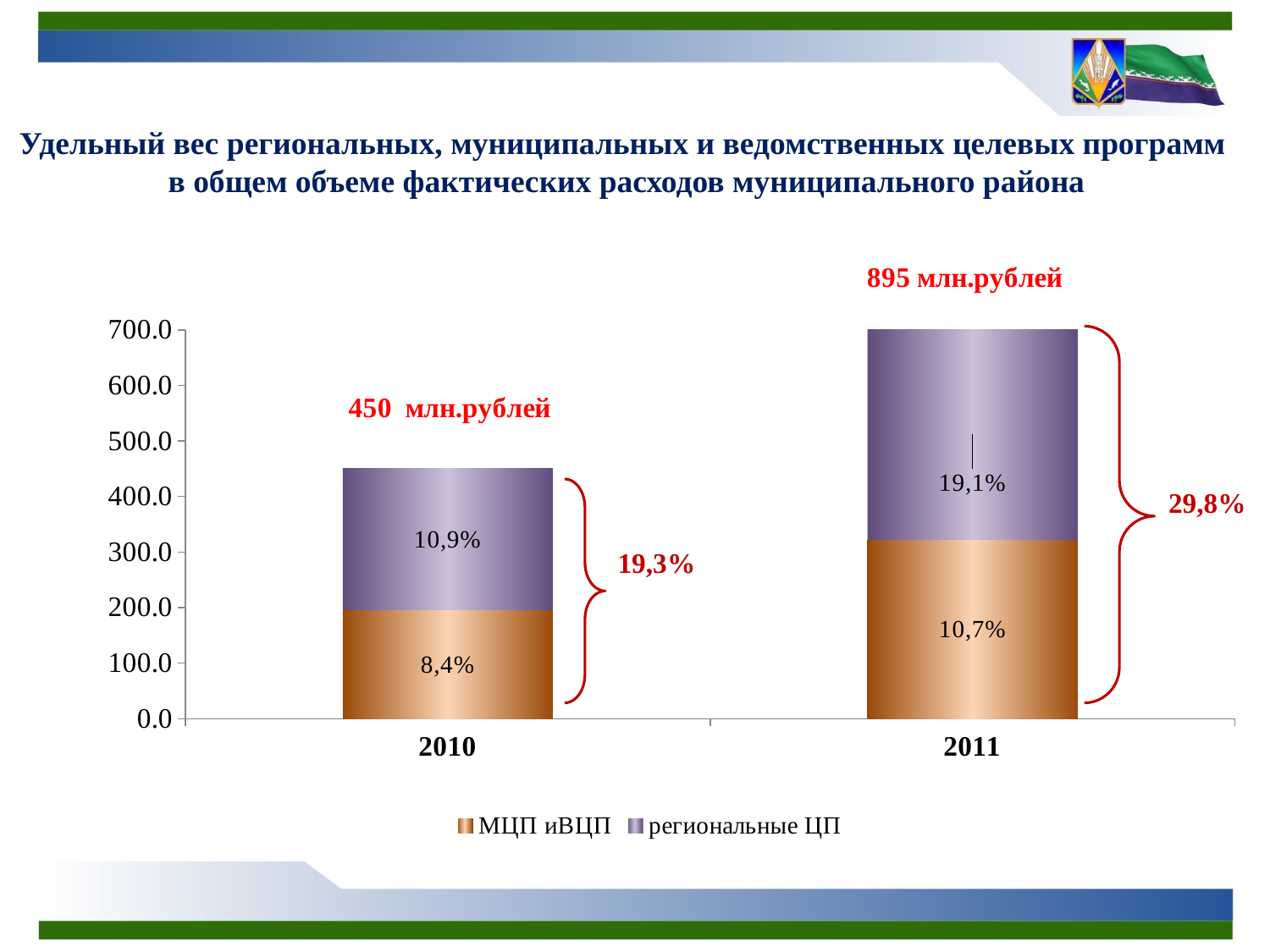
How many series does the legend list? 2 What percentage label is shown on the МЦП иВЦП segment for 2010? 8,4% What total amount in million rubles is annotated above the 2011 bar? 895 млн.рублей Is the top of the МЦП иВЦП segment for 2011 greater or less than 300 on the y axis? greater How many years are shown on the x axis? 2 What percentage label is shown on the региональные ЦП segment for 2011? 19,1% What kind of chart is shown on the slide? stacked bar chart What is the difference between the региональные ЦП percentage labels for 2011 and 2010? 8,2% What percentage label is shown on the МЦП иВЦП segment for 2011? 10,7% Which year has the larger percentage label for региональные ЦП, 2010 or 2011? 2011 What percentage label is shown on the региональные ЦП segment for 2010? 10,9% What combined percentage is shown next to the brace for the 2010 bar? 19,3%